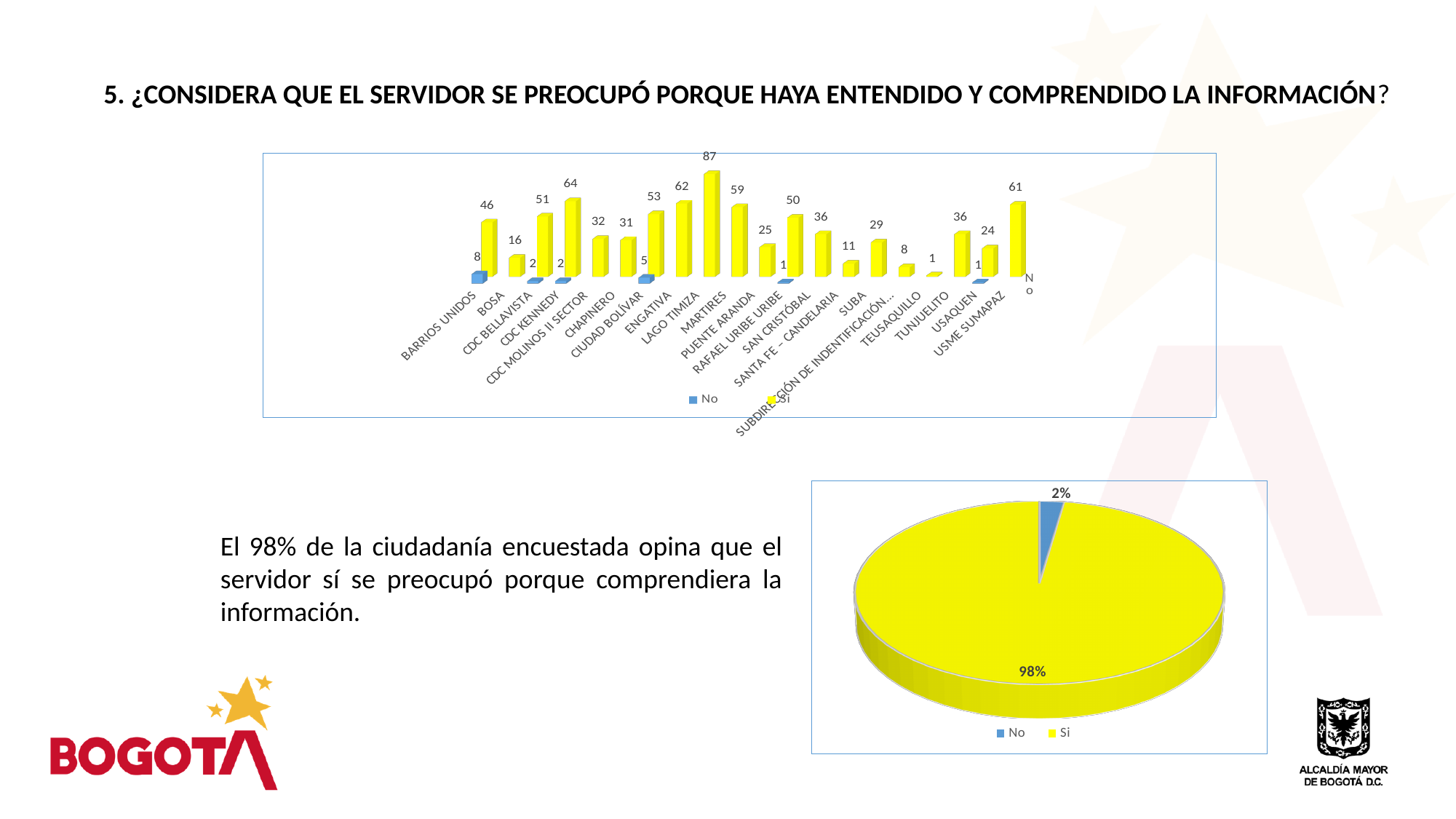
In the top bar chart, which category has the highest "Si" value? LAGO TIMIZA In the top bar chart, what is the "No" value for BARRIOS UNIDOS? 8 In the top bar chart, what is the difference between the "Si" values for LAGO TIMIZA and USME SUMAPAZ? 26 How many series does the legend of the pie chart list? 2 In the pie chart, which slice is larger, "No" or "Si"? Si In the top bar chart, what is the "Si" value for CDC KENNEDY? 64 In the top bar chart, which colour represents the "Si" series? Yellow In the pie chart, what percentage of respondents answered "No"? 2% In the pie chart, what percentage of respondents answered "Si"? 98% What kind of chart is shown at the top of the slide? Bar chart In the top bar chart, what is the "Si" value for LAGO TIMIZA? 87 What kind of chart is shown at the bottom right of the slide? Pie chart